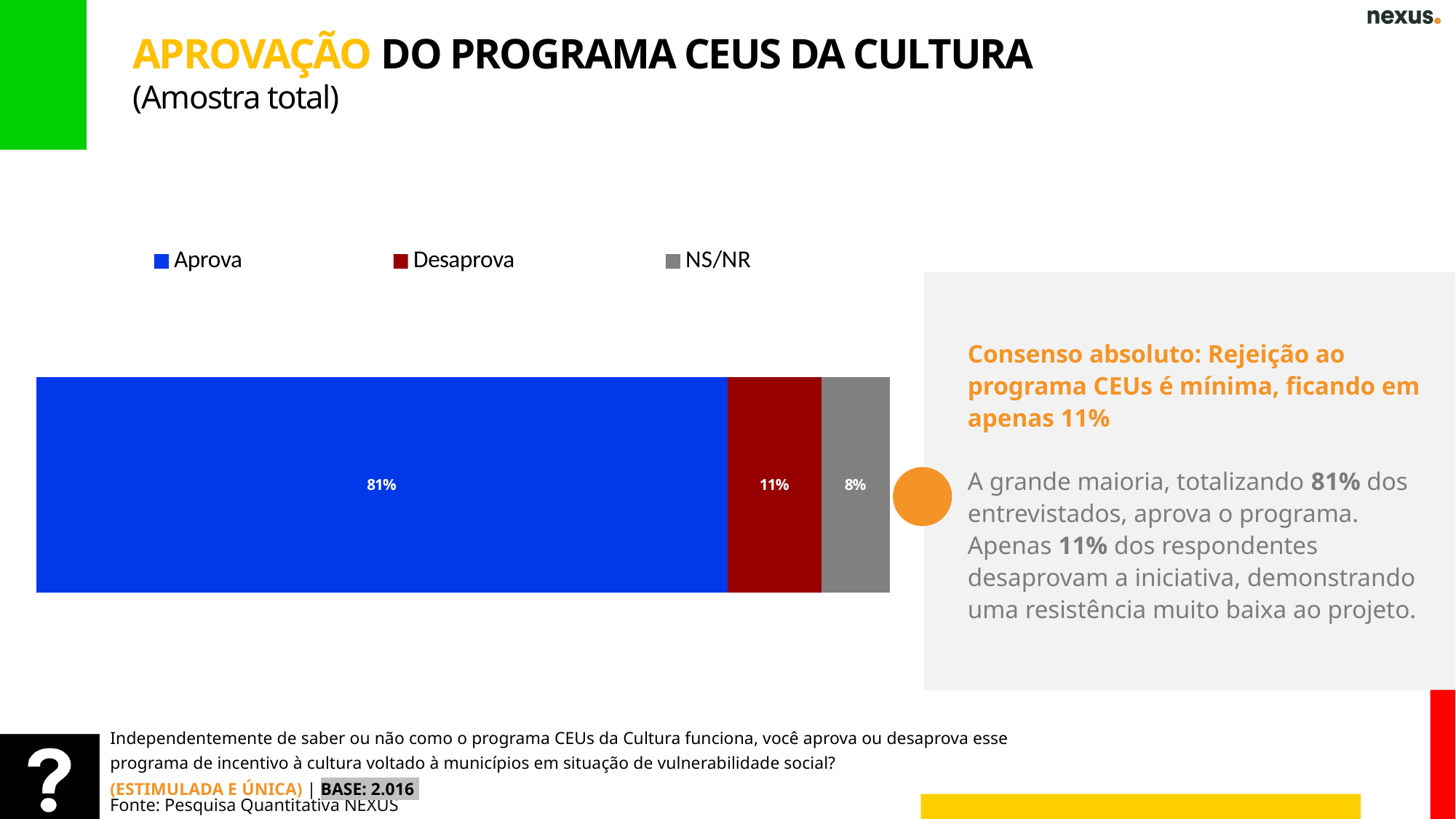
Which is larger, the share for Desaprova or the share for NS/NR? Desaprova Which response category has the highest share? Aprova What percentage of respondents approve (Aprova) the CEUs da Cultura program? 81% What is the value shown for NS/NR? 8% What is the difference in percentage points between Desaprova and NS/NR? 3 What percentage of respondents disapprove (Desaprova) the program? 11% What is the difference in percentage points between Aprova and Desaprova? 70 What colour represents the Desaprova segment in the chart? Dark red Which response category has the lowest share? NS/NR What kind of chart is shown on the slide? Stacked bar chart What is the total of the three segments in the stacked bar? 100% How many series does the legend list? 3